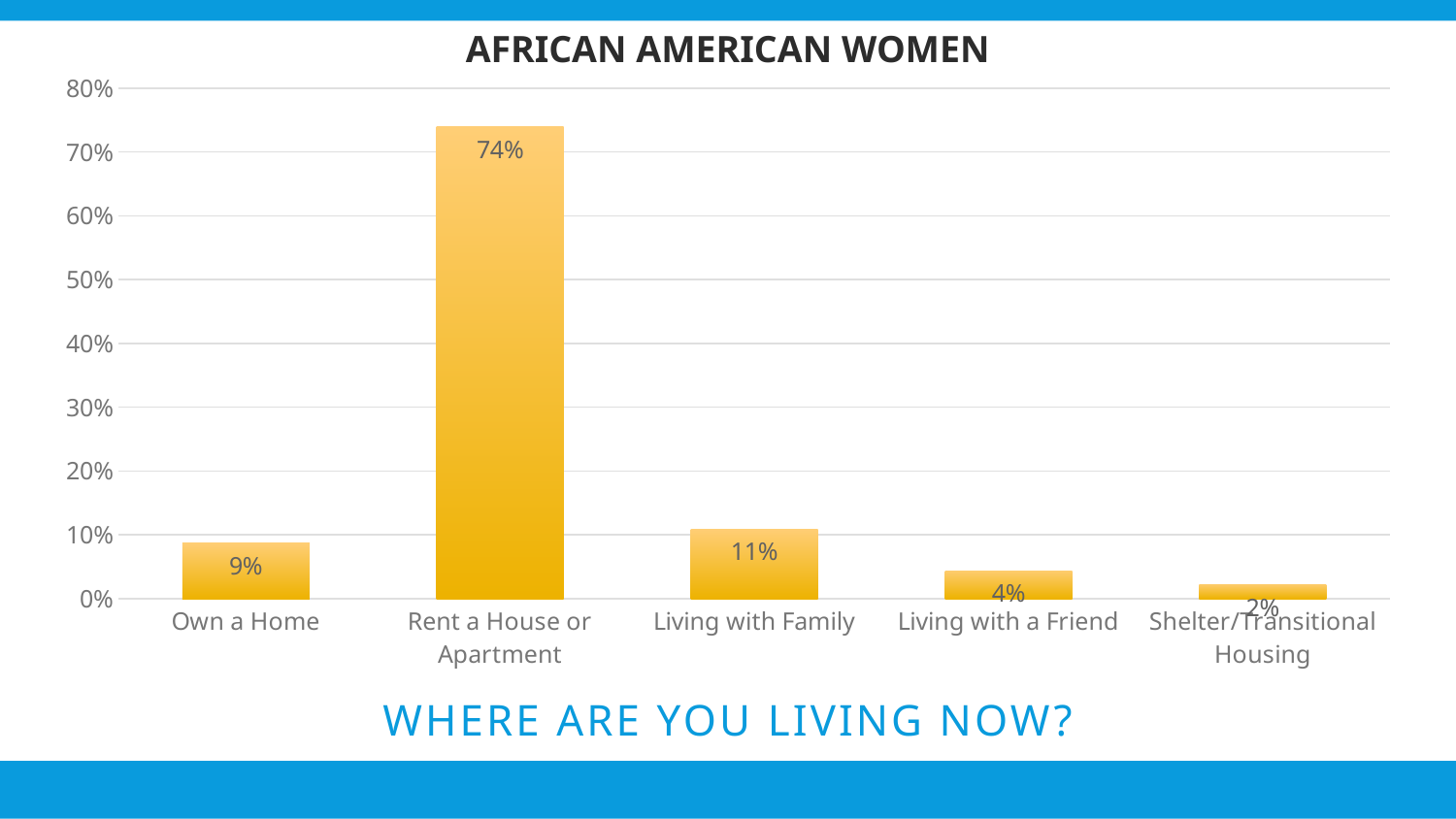
What is the title of the chart? AFRICAN AMERICAN WOMEN What is the difference between Rent a House or Apartment and Living with Family? 63% What percentage of African American women rent a house or apartment? 74% How many categories are shown on the x axis? 5 Which is larger, Own a Home or Living with a Friend? Own a Home Which category has the lowest value? Shelter/Transitional Housing Which category has the highest value? Rent a House or Apartment What is the value for Living with a Friend? 4% What is the value for Own a Home? 9% What is the value for Living with Family? 11% What kind of chart is this? Bar chart What is the difference between Living with Family and Own a Home? 2%